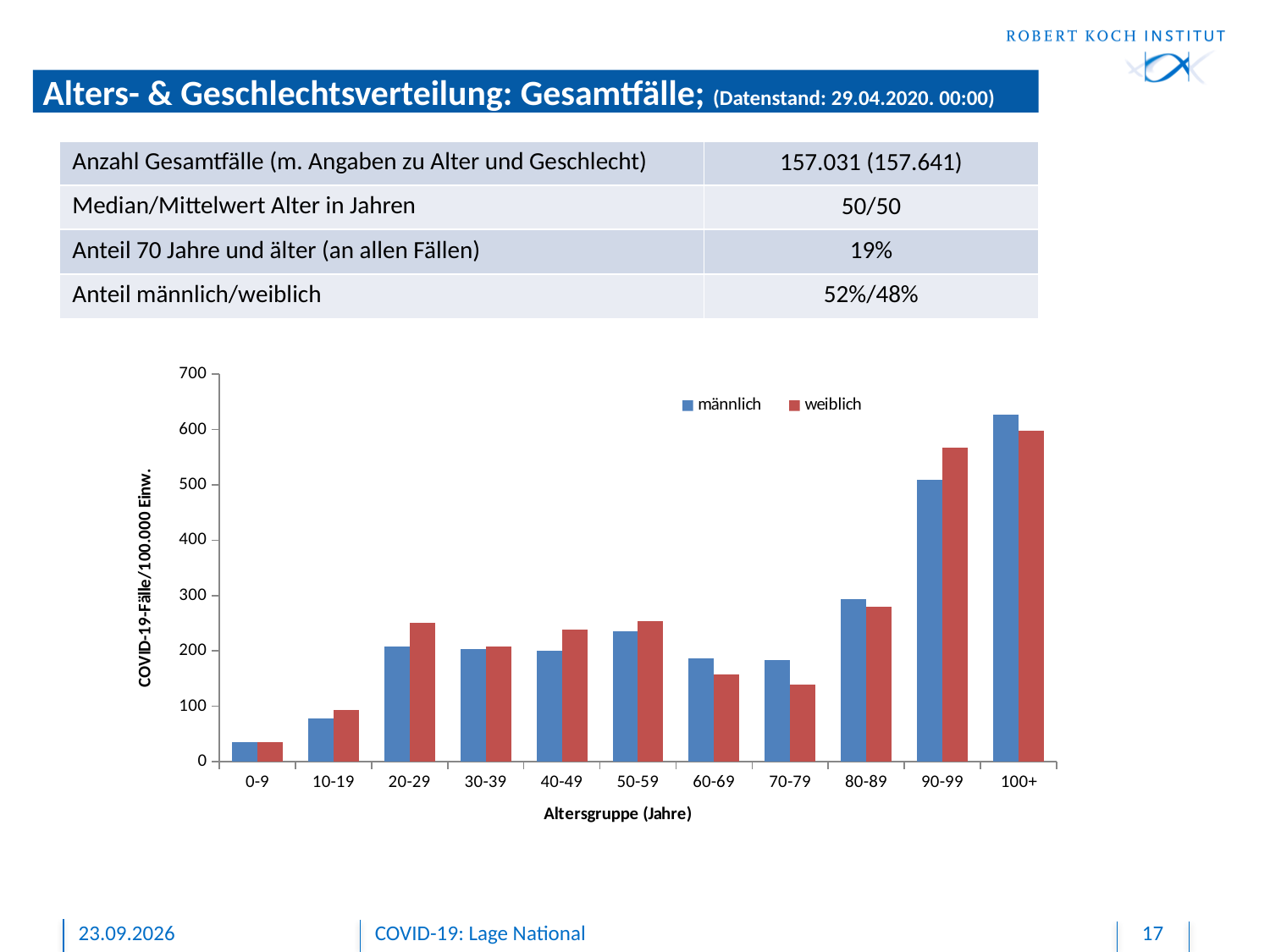
What is the label of the chart's y axis? COVID-19-Fälle/100.000 Einw. Which age group has the lowest value for weiblich? 0-9 In the 90-99 age group, which is larger, männlich or weiblich? weiblich Do the values for männlich rise or fall from the 70-79 age group to the 100+ age group? rise Is the value for weiblich in the 70-79 age group greater or less than 200? less Which age group has the highest value for männlich? 100+ How many series does the chart's legend list? 2 Is the value for männlich in the 100+ age group greater or less than 600? greater What kind of chart is shown on the slide? bar chart How many age groups are shown on the x axis of the chart? 11 Is the value for weiblich in the 90-99 age group greater or less than 500? greater In the 70-79 age group, which is larger, männlich or weiblich? männlich